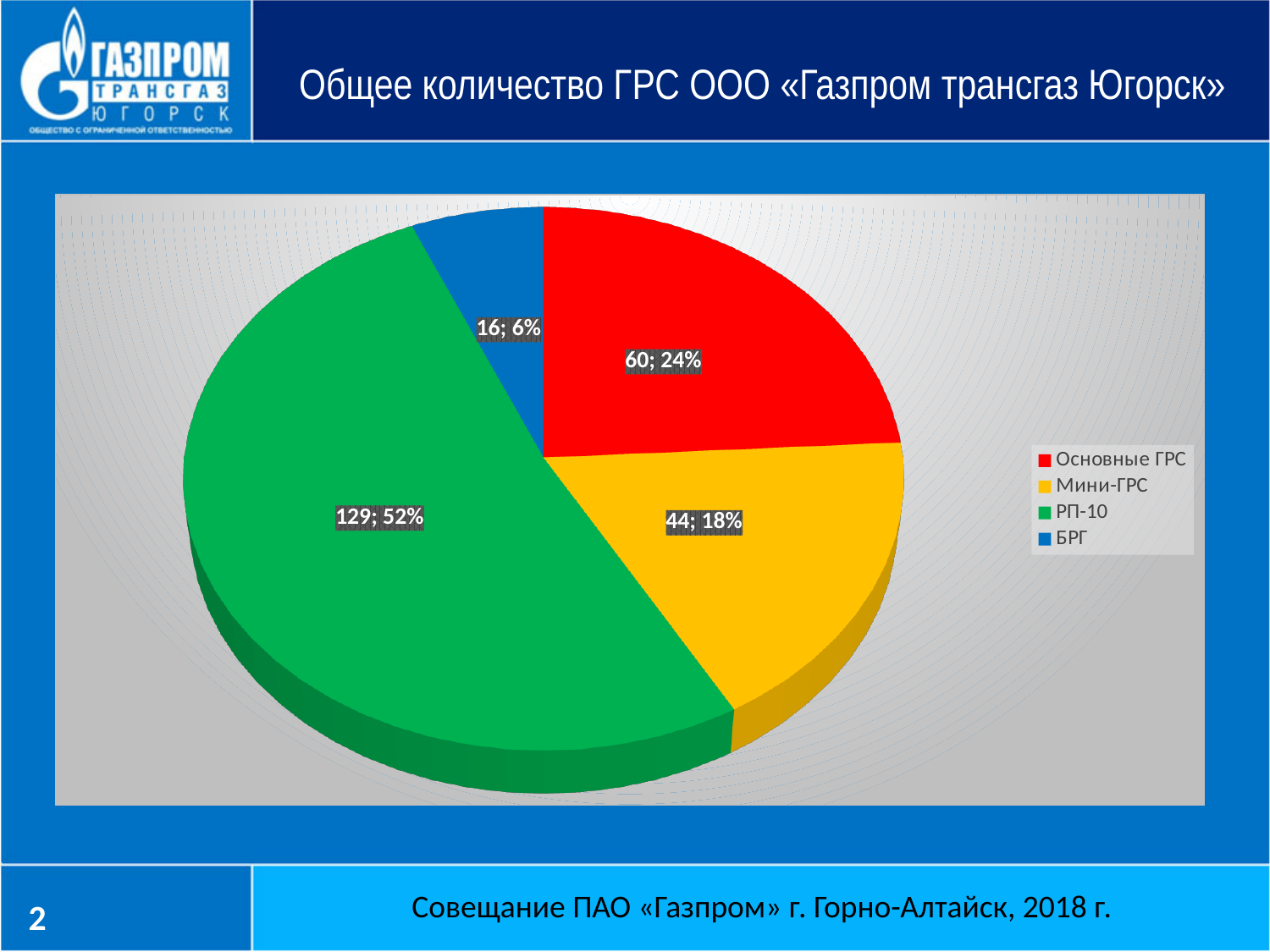
How many slices does the pie chart have? 4 Which category has the largest slice? РП-10 What is the value for БРГ? 16 How many entries does the legend list? 4 What share of the pie does РП-10 represent? 52% What kind of chart is shown on the slide? pie chart What is the value for Основные ГРС? 60 What is the difference between the values for РП-10 and Основные ГРС? 69 Which category has the smallest slice? БРГ Which colour represents Мини-ГРС in the chart? yellow What is the value for Мини-ГРС? 44 What is the value for РП-10? 129